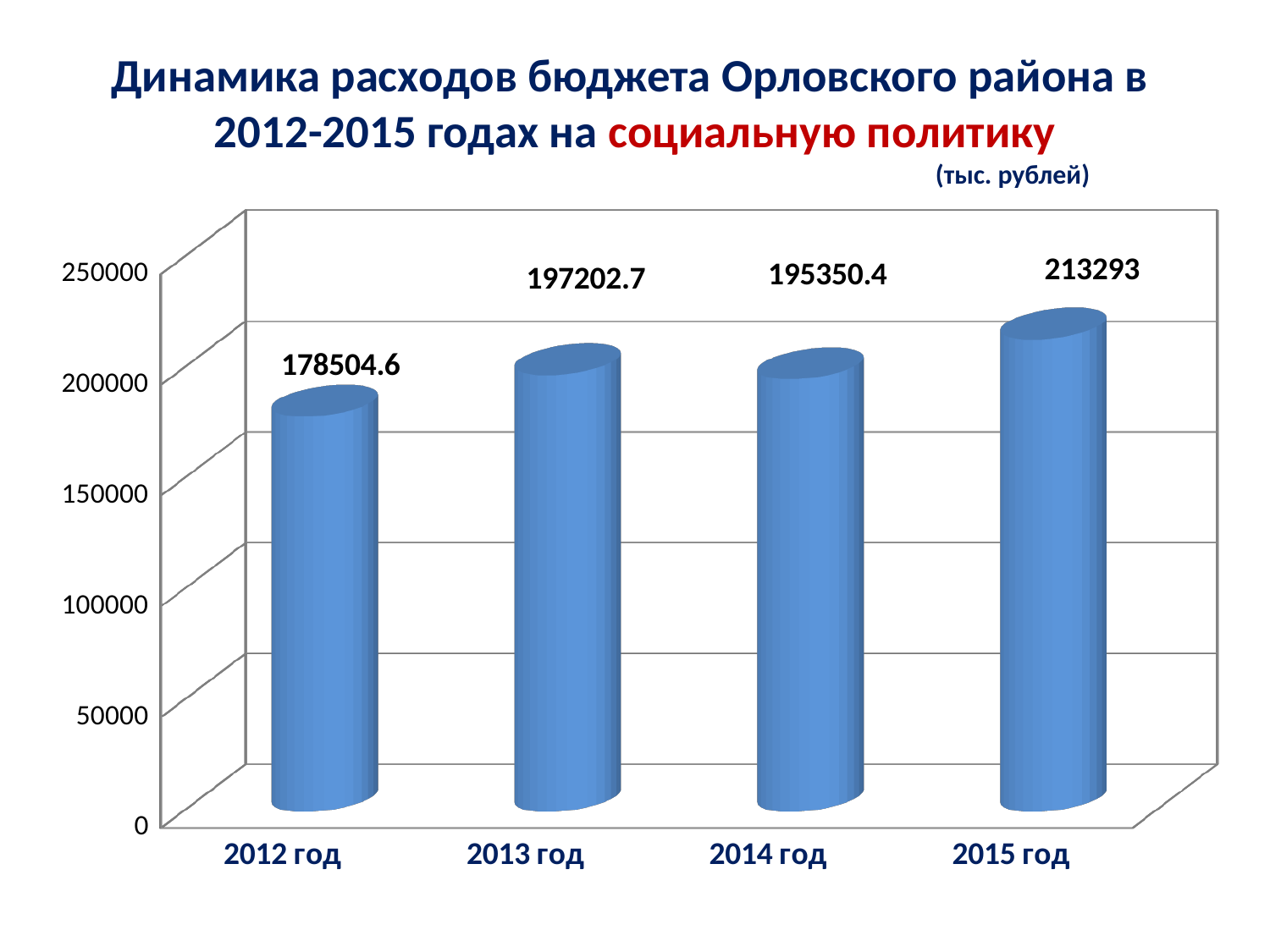
What is the difference between the values for 2013 год and 2014 год? 1852.3 What kind of chart is shown on the slide? bar chart Is the value for 2012 год greater or less than 200000? less Which year has the highest value? 2015 год How many years are shown on the chart? 4 What unit is stated for the values on the chart? тыс. рублей What is the value for 2012 год? 178504.6 Which year has the lowest value? 2012 год What is the difference between the values for 2015 год and 2012 год? 34788.4 Which is larger, the value for 2012 год or the value for 2013 год? 2013 год What is the value for 2015 год? 213293 What is the value for 2014 год? 195350.4